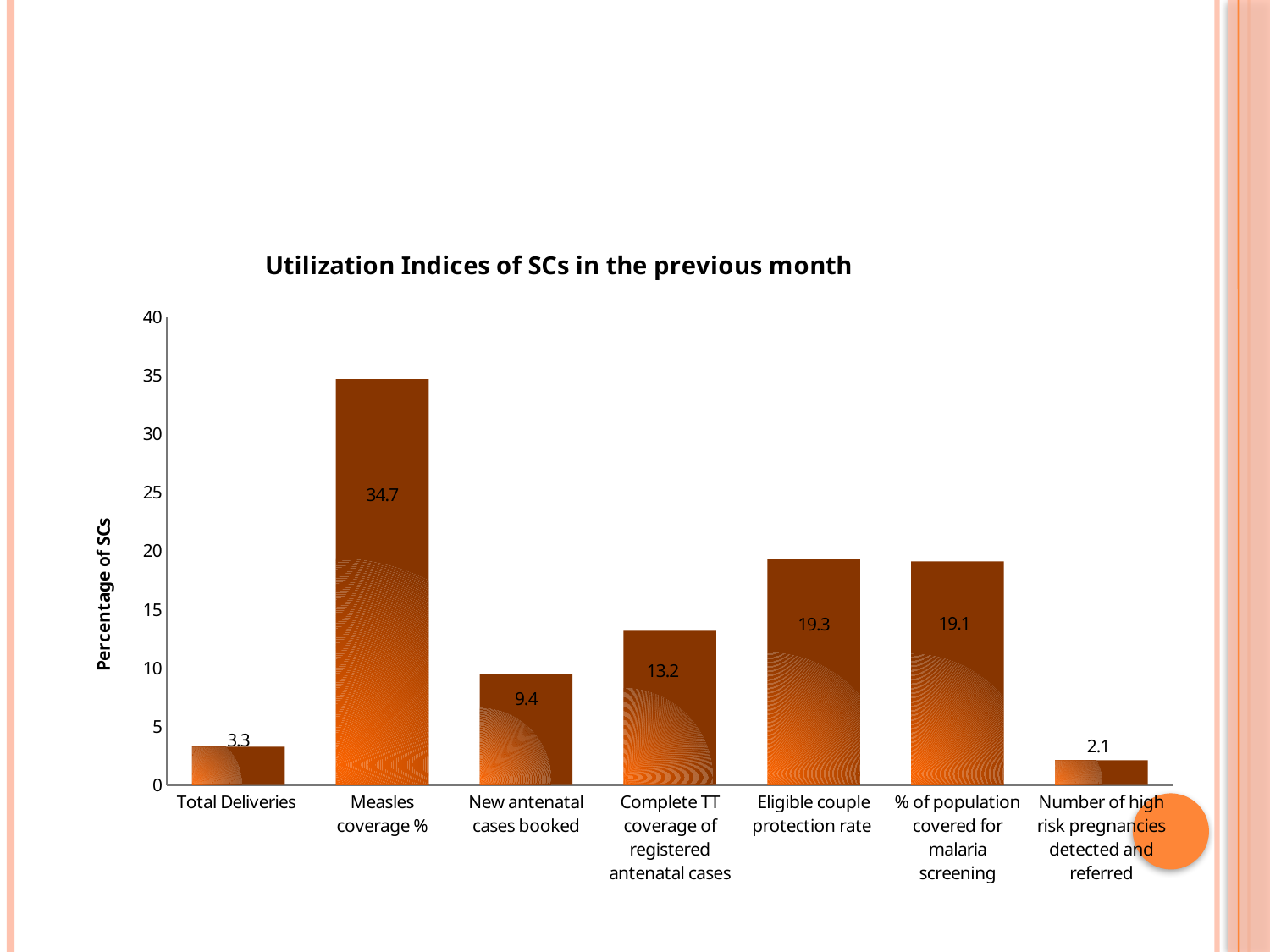
Is the value for Eligible couple protection rate greater or less than 15? greater What kind of chart is shown on the slide? Bar chart What is the title of the chart? Utilization Indices of SCs in the previous month What is the value for Measles coverage %? 34.7 How many categories are shown on the x axis? 7 What is the difference between the values for Measles coverage % and New antenatal cases booked? 25.3 Which category has the highest value? Measles coverage % Which is larger: the value for Eligible couple protection rate or the value for Complete TT coverage of registered antenatal cases? Eligible couple protection rate What is the value for Complete TT coverage of registered antenatal cases? 13.2 What is the value for Total Deliveries? 3.3 What is the value for Number of high risk pregnancies detected and referred? 2.1 Which category has the lowest value? Number of high risk pregnancies detected and referred